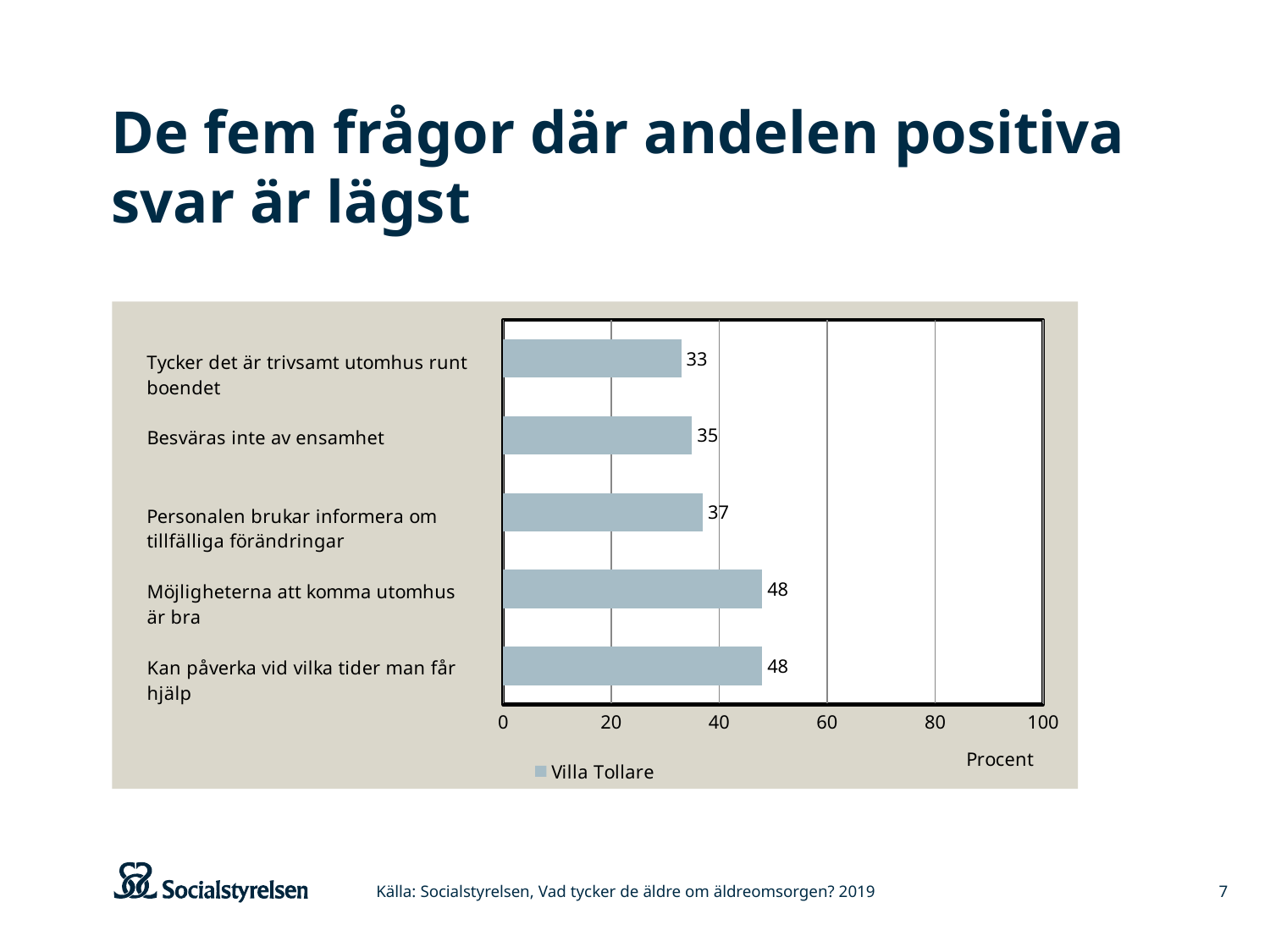
How many categories are shown in the chart? 5 How many series does the legend list? 1 What is the value for "Personalen brukar informera om tillfälliga förändringar"? 37 What is the value for "Kan påverka vid vilka tider man får hjälp"? 48 What is the value for "Tycker det är trivsamt utomhus runt boendet"? 33 Which category has the lowest value? Tycker det är trivsamt utomhus runt boendet What is the difference between the values for "Möjligheterna att komma utomhus är bra" and "Besväras inte av ensamhet"? 13 Is the value for "Kan påverka vid vilka tider man får hjälp" greater or less than 40? greater What is the name of the series shown in the legend? Villa Tollare What kind of chart is shown on the slide? bar chart Which is larger, the value for "Personalen brukar informera om tillfälliga förändringar" or the value for "Tycker det är trivsamt utomhus runt boendet"? Personalen brukar informera om tillfälliga förändringar What is the value for "Besväras inte av ensamhet"? 35